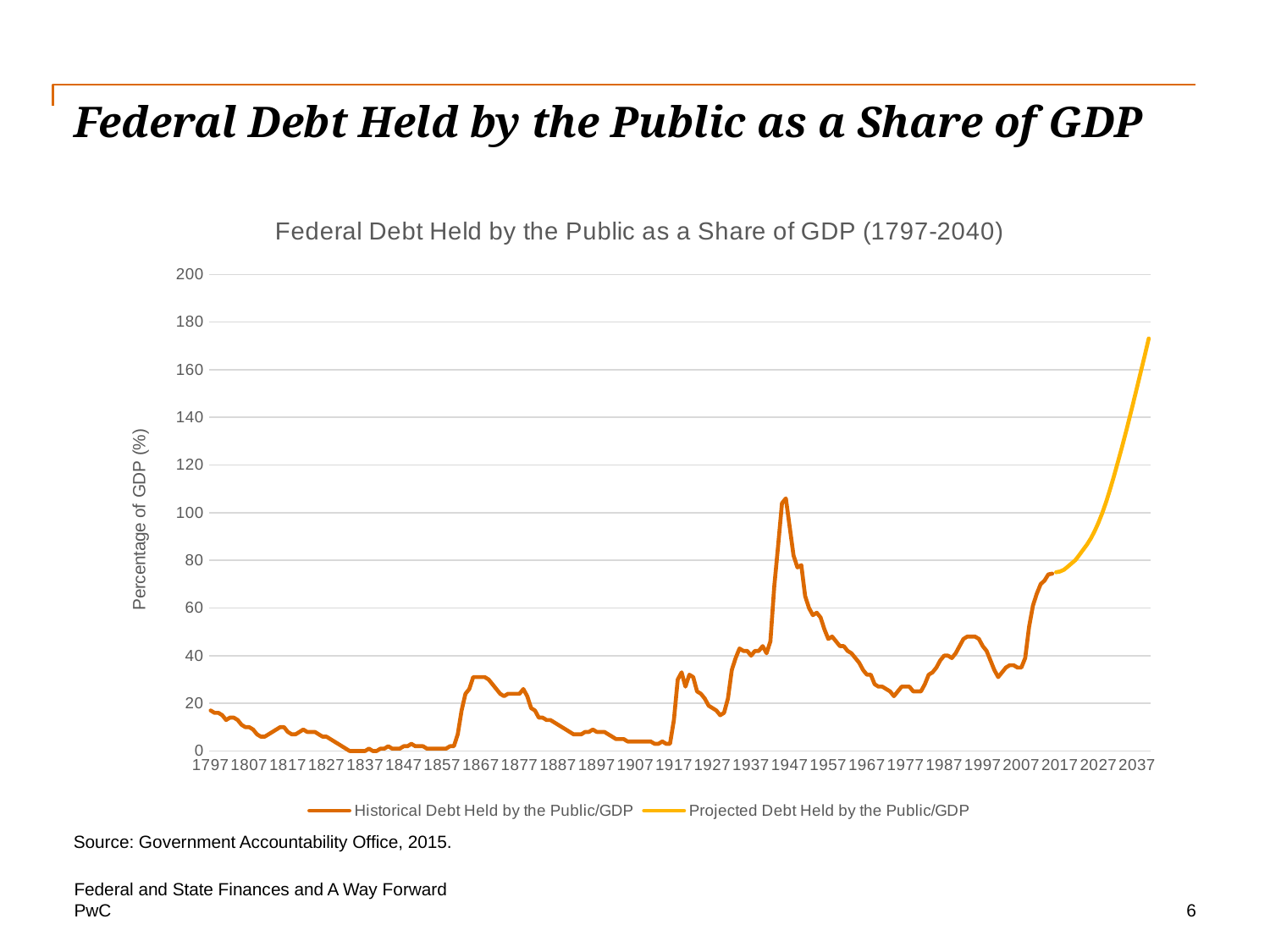
How many year labels are shown on the x axis? 25 What kind of chart is shown on the slide? Line chart Is the historical value in 1867 greater or less than 20? greater What is the title of the chart? Federal Debt Held by the Public as a Share of GDP (1797-2040) Does the projected series rise or fall from 2017 to 2040? rises How many series does the legend list? 2 Is the value around 1947 higher or lower than the value in 1997? higher Is the historical value in 1977 greater or less than 40? less Is the projected value at 2037 greater or less than 140? greater What is the label on the vertical axis? Percentage of GDP (%)